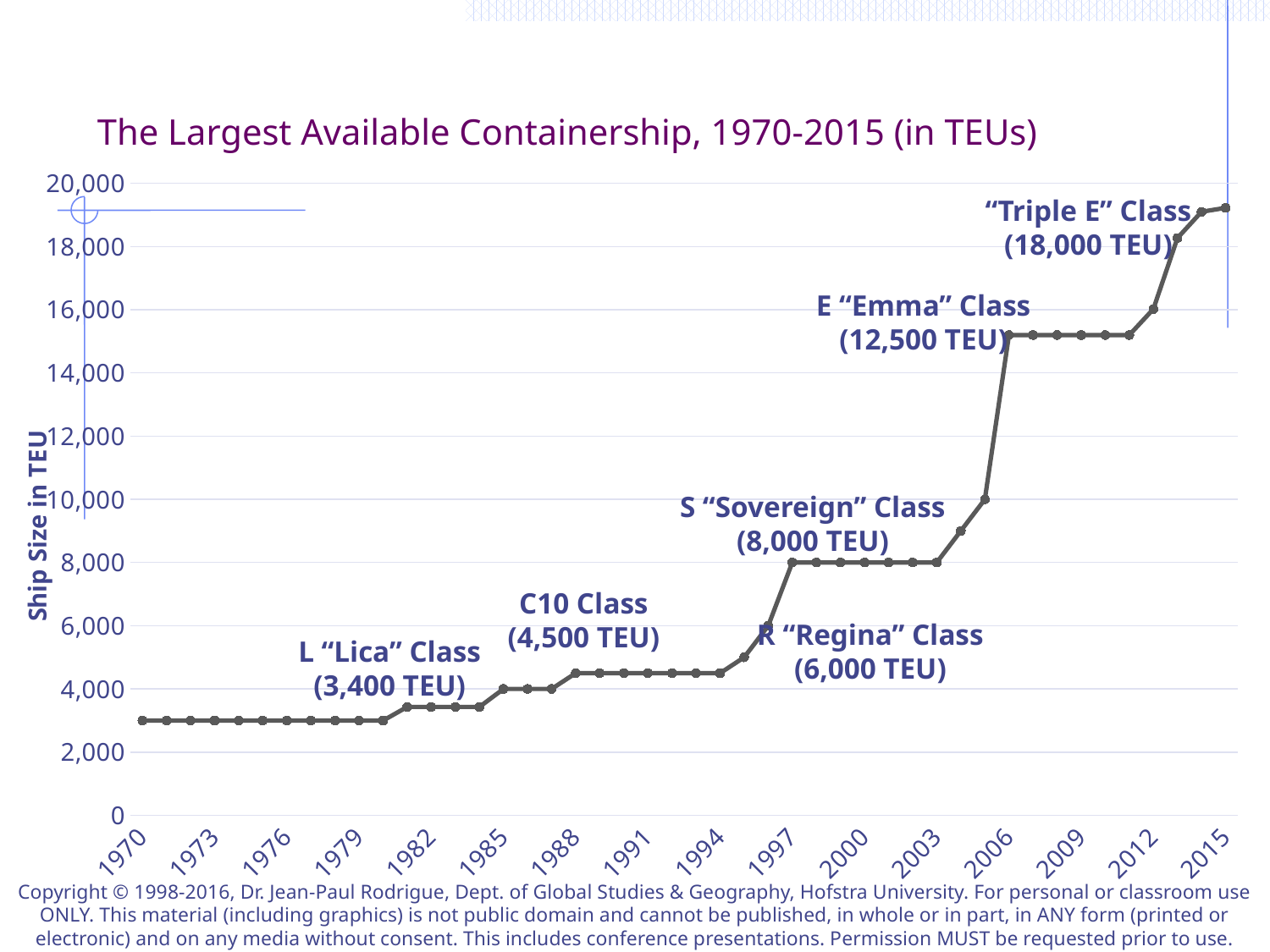
Is the value for 1970 greater or less than 4,000? less Do the values generally rise or fall from 1970 to 2015? rise How many ship classes are annotated on the chart? 6 Is the value for 2015 greater or less than 18,000? greater What kind of chart is shown on the slide? line chart What is the label of the vertical axis? Ship Size in TEU According to the annotation, what capacity is listed for the "Triple E" Class? 18,000 TEU Is the value for 2000 greater or less than 10,000? less Which year has the highest ship size value on the chart? 2015 What is the title of the chart? The Largest Available Containership, 1970-2015 (in TEUs) According to the annotation, what capacity is listed for the S "Sovereign" Class? 8,000 TEU